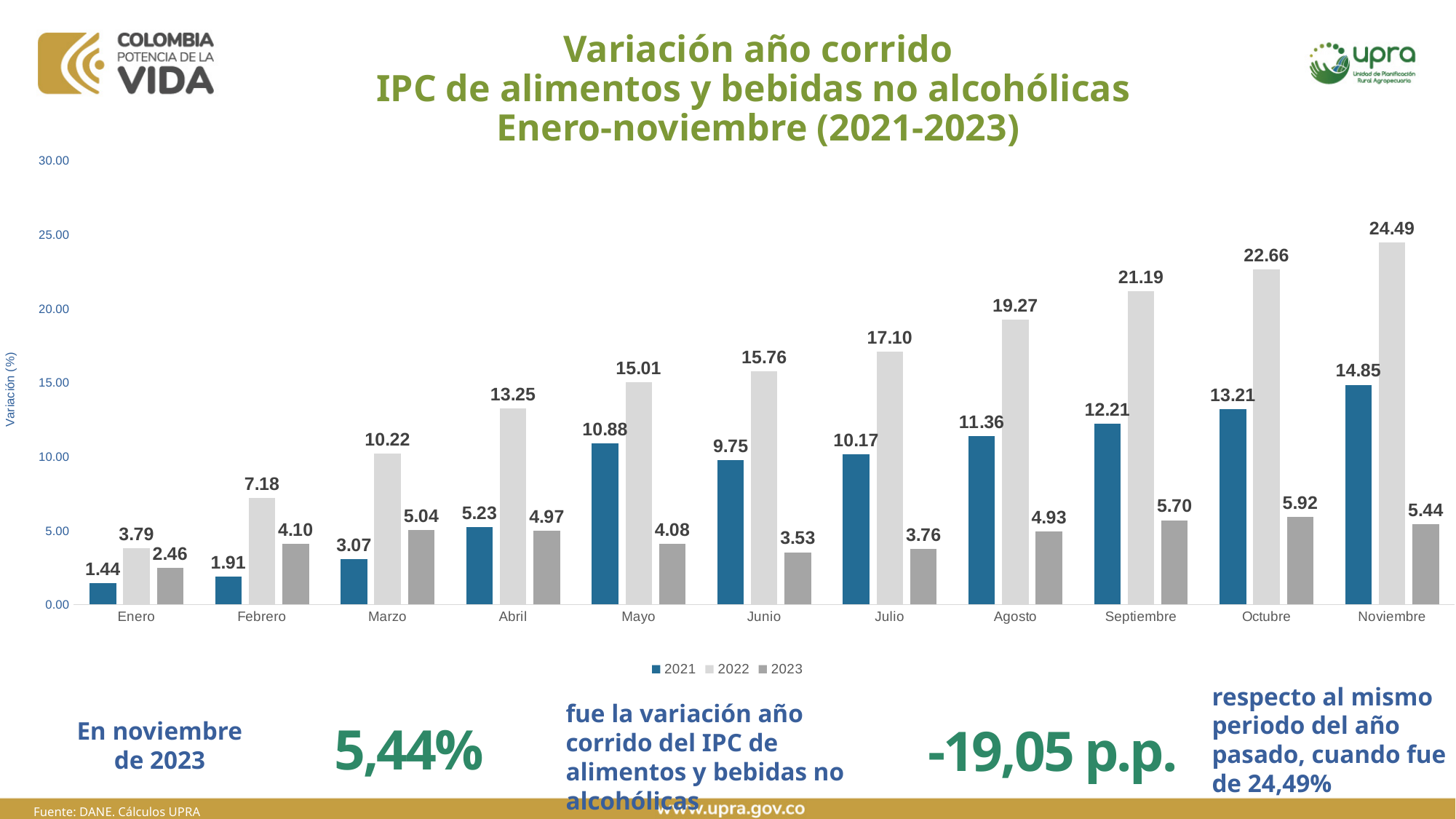
What is the value for 2022 in Noviembre? 24.49 What is the value for 2021 in Mayo? 10.88 Do the values for the 2022 series rise or fall from Enero to Noviembre? rise What is the label of the y axis? Variación (%) Which is larger in Abril: the 2021 value or the 2023 value? 2021 How many series does the legend list? 3 What is the value for 2023 in Marzo? 5.04 Which month has the highest value for the 2023 series? Octubre What is the difference between the 2022 and 2023 values in Noviembre? 19.05 How many months are shown on the x axis? 11 What kind of chart is shown on the slide? bar chart Which month has the lowest value for the 2021 series? Enero